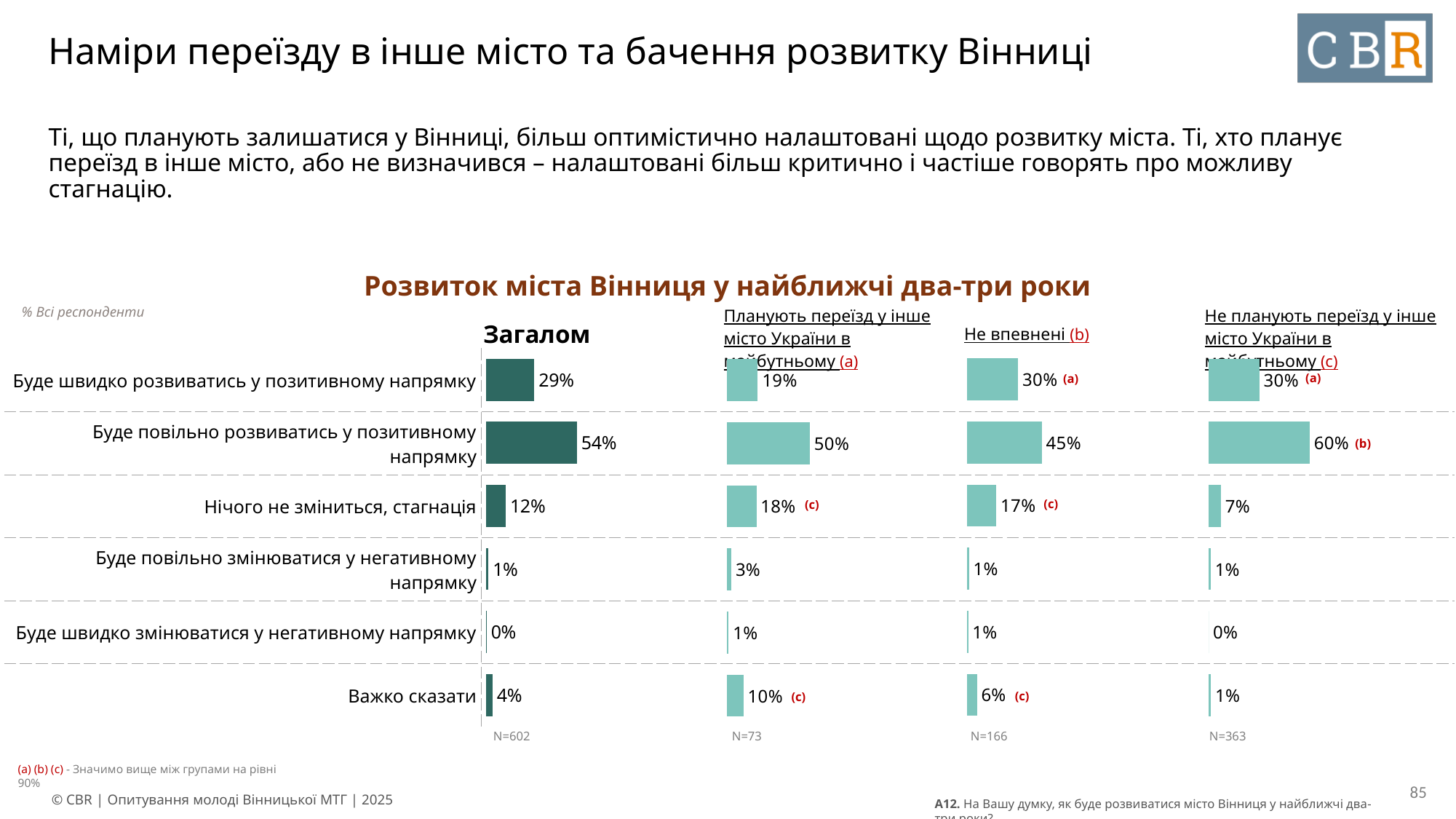
What type of chart is used on this slide? Bar chart In the "Загалом" chart, what is the value for "Буде повільно розвиватись у позитивному напрямку"? 54% In the "Загалом" chart, what is the value for "Буде швидко розвиватись у позитивному напрямку"? 29% In the "Загалом" chart, which category has the lowest value? Буде швидко змінюватися у негативному напрямку What is the title of the chart section on the slide? Розвиток міста Вінниця у найближчі два-три роки What is the difference between the "Буде повільно розвиватись у позитивному напрямку" values in the "Не планують переїзд" (c) chart and the "Планують переїзд" (a) chart? 10 percentage points How many categories are shown in each chart? 6 In the "Планують переїзд у інше місто України в майбутньому (a)" chart, what is the value for "Важко сказати"? 10% In the "Не планують переїзд у інше місто України в майбутньому (c)" chart, which category has the highest value? Буде повільно розвиватись у позитивному напрямку What is the sample size (N) shown under the "Не впевнені (b)" chart? N=166 Which is larger: the "Нічого не зміниться, стагнація" value in the "Планують переїзд" (a) chart or in the "Не планують переїзд" (c) chart? Планують переїзд (a) In the "Не впевнені (b)" chart, what is the value for "Нічого не зміниться, стагнація"? 17%